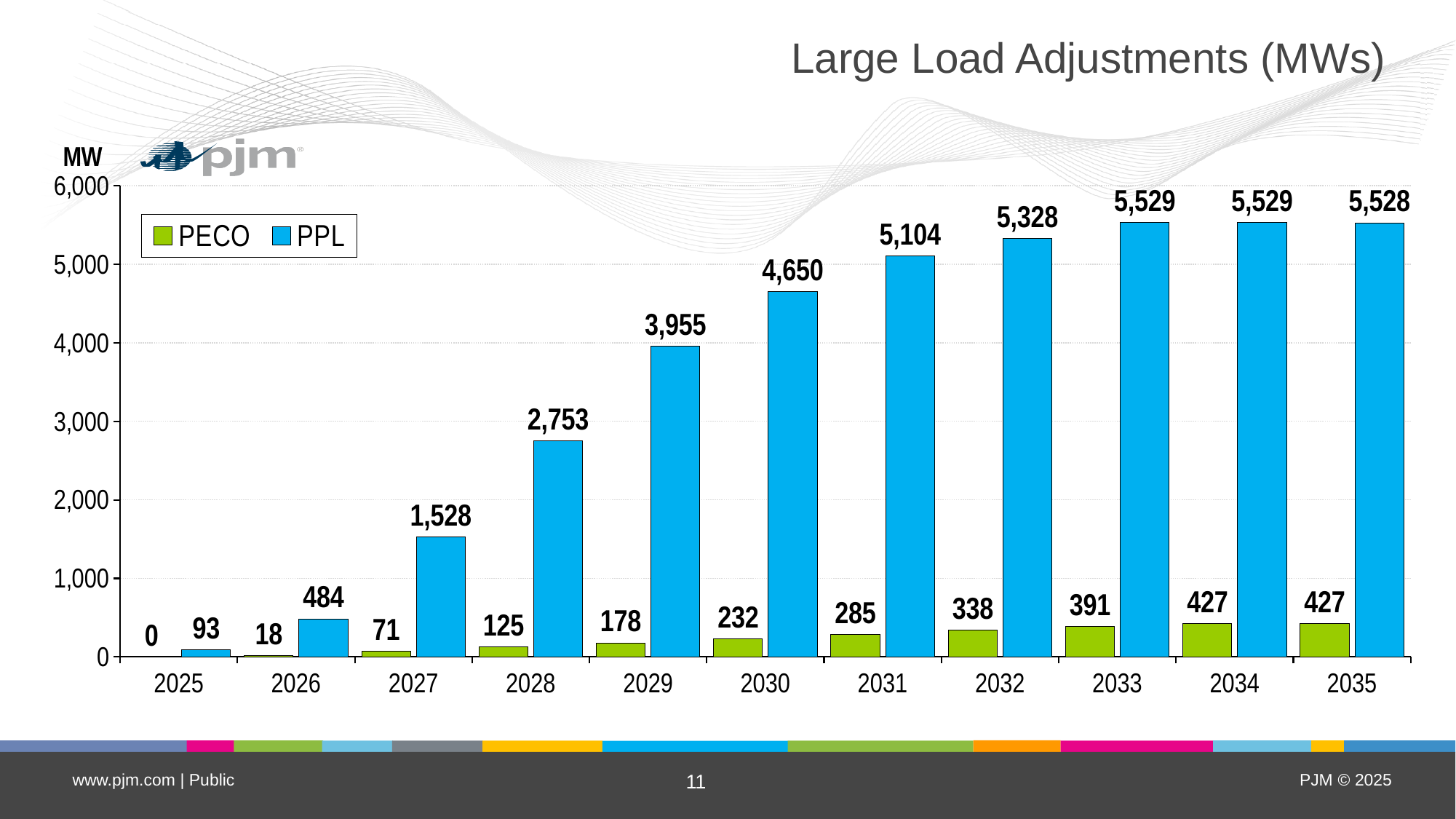
How many series does the legend list? 2 What is the PECO value for 2032? 338 What kind of chart is shown? bar chart Which is larger in 2028, the PPL value or the PECO value? PPL Is the PPL value for 2031 greater or less than 5,000? greater Which year has the lowest PPL value? 2025 What is the PPL value for 2027? 1,528 What is the difference between the PPL and PECO values in 2029? 3,777 What is the PPL value for 2030? 4,650 Which year has the highest PECO value? 2034 and 2035 Do the PPL values rise or fall from 2025 to 2033? rise How many years are shown on the x axis? 11